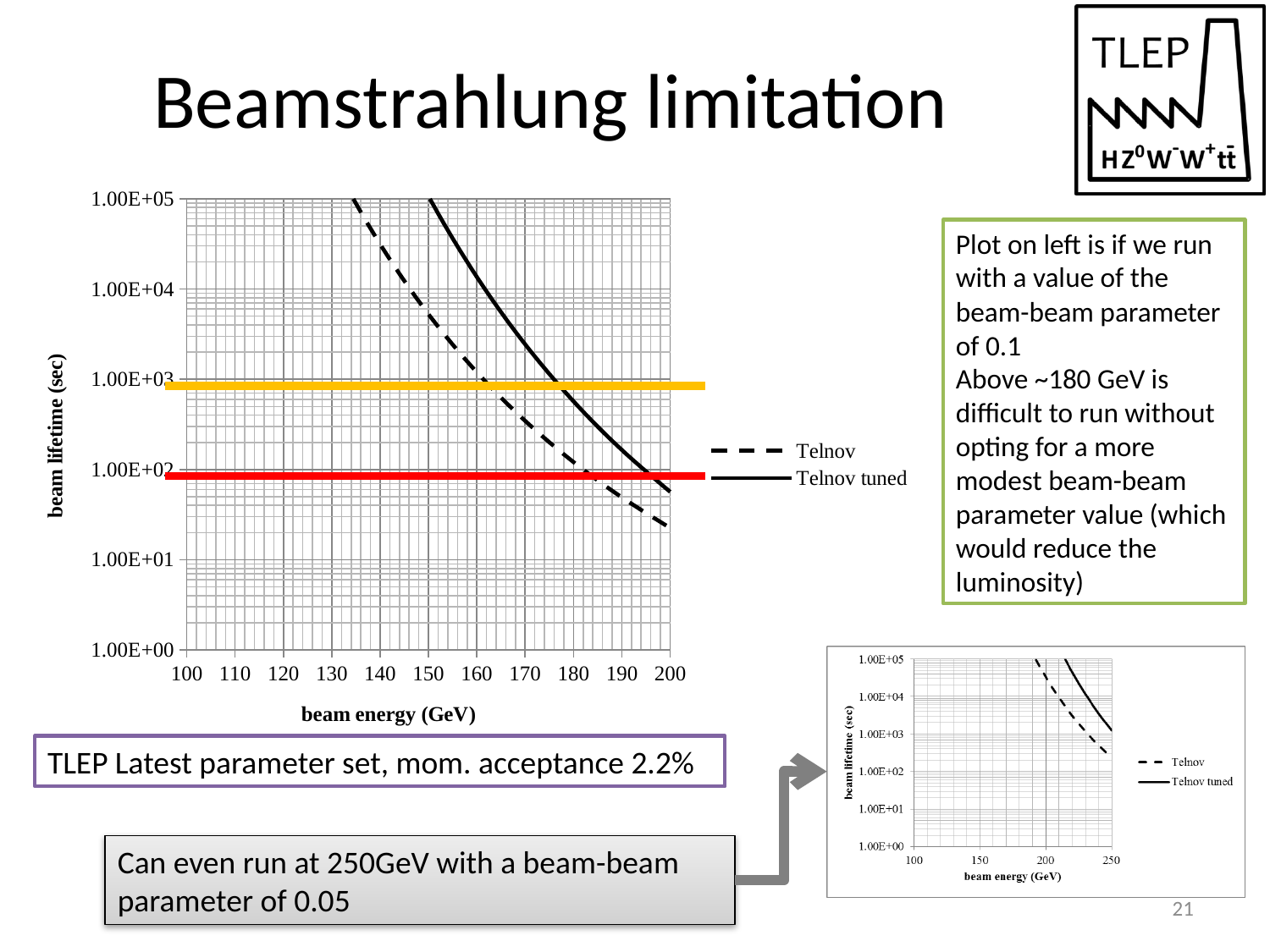
In the small chart at the bottom right, does the beam lifetime rise or fall as beam energy increases? fall In the large chart on the left, is the beam lifetime for Telnov at 200 GeV greater or less than 1.00E+02 sec? less What kind of chart is the large chart on the left of the slide? line chart How many series does the legend of the large chart on the left list? 2 In the large chart on the left, at a beam energy of 180 GeV, which series has the higher beam lifetime, Telnov or Telnov tuned? Telnov tuned In the large chart on the left, what is the label of the x axis? beam energy (GeV) In the large chart on the left, is the beam lifetime for Telnov tuned at 160 GeV greater or less than 1.00E+03 sec? greater What kind of chart is the small chart at the bottom right of the slide? line chart In the large chart on the left, what are the two series named in the legend? Telnov and Telnov tuned In the large chart on the left, which series is drawn with a dashed line? Telnov In the large chart on the left, does the beam lifetime rise or fall as beam energy increases? fall In the large chart on the left, is the beam lifetime for Telnov at 150 GeV greater or less than 1.00E+03 sec? greater